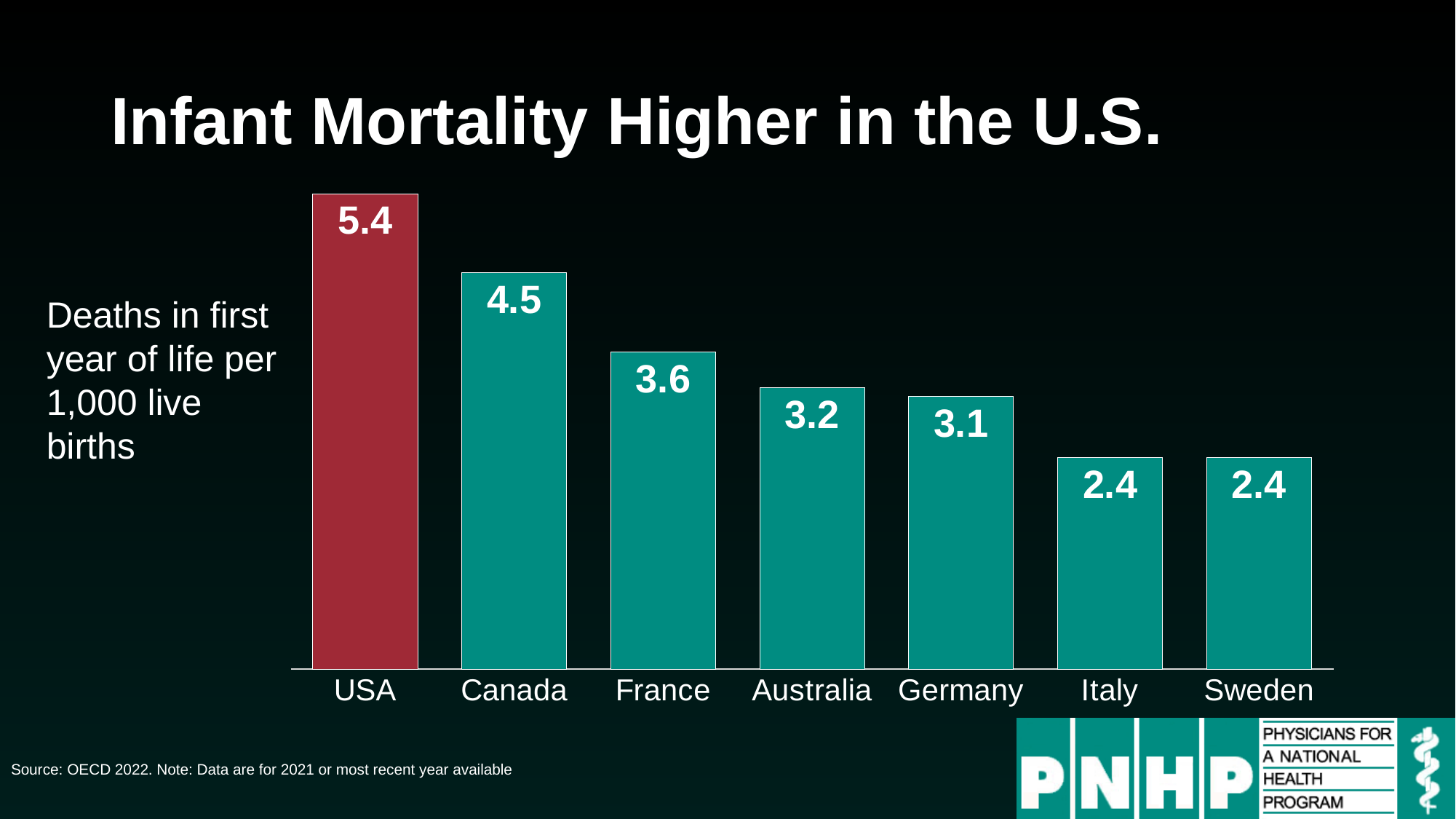
How many countries are shown on the chart? 7 What is the lowest value shown on the chart? 2.4 What is the value shown for Germany? 3.1 What is the infant mortality value shown for the USA? 5.4 What is the difference between the France value and the Sweden value? 1.2 Which bar is coloured differently from the others? USA What is the value shown for Canada? 4.5 Which country has the highest infant mortality on the chart? USA Which has a higher value, France or Australia? France What is the difference between the USA value and the Canada value? 0.9 What kind of chart is shown on the slide? Bar chart Do the values rise or fall moving from left to right across the chart? Fall